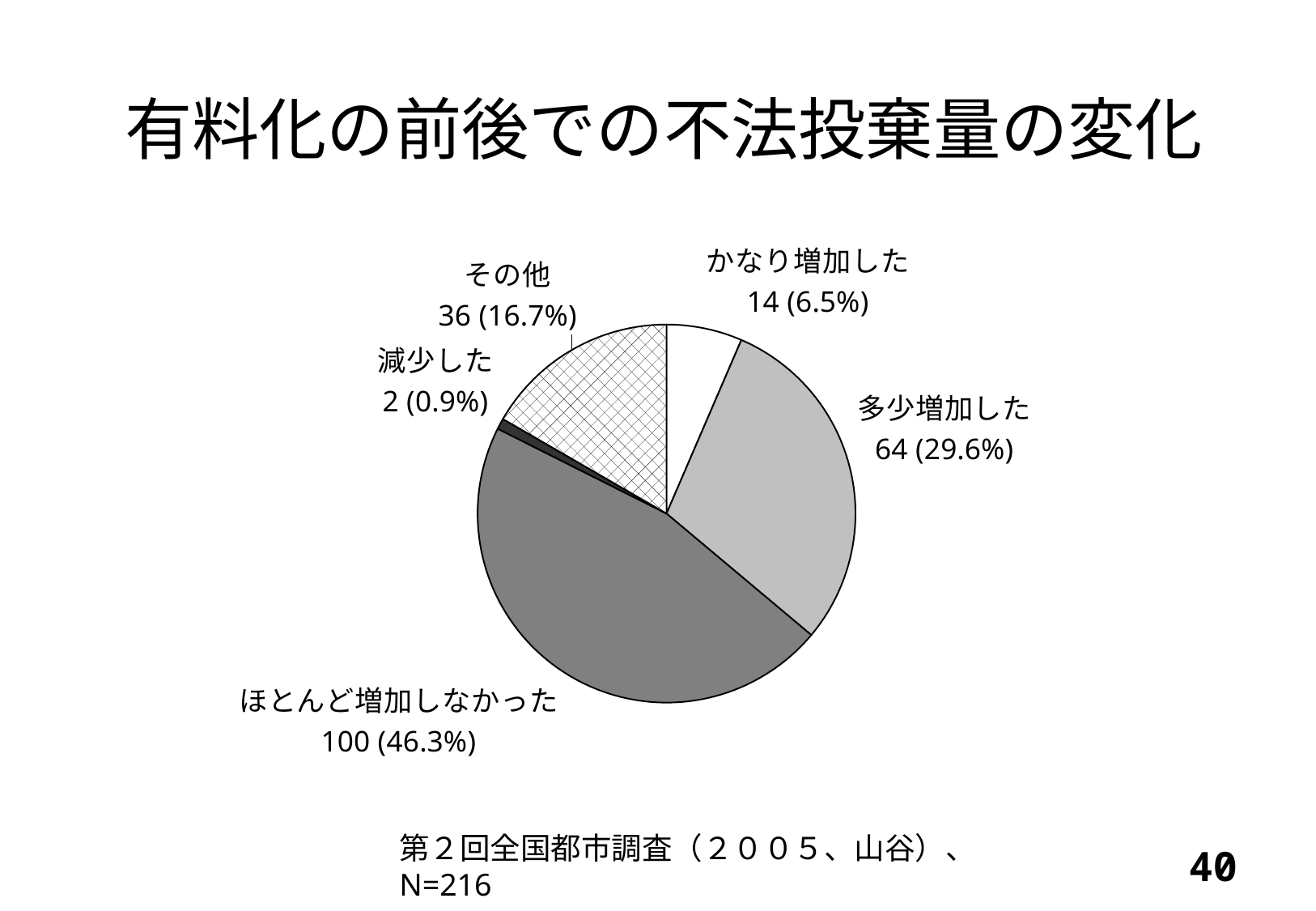
What is the percentage share of 減少した? 0.9% What percentage share does その他 have? 16.7% Which category has the largest slice? ほとんど増加しなかった What is the count for ほとんど増加しなかった? 100 What is the count for かなり増加した? 14 How many slices does the pie chart have? 5 Which is larger, the count for その他 or the count for かなり増加した? その他 What percentage share does 多少増加した have? 29.6% What kind of chart is shown on the slide? pie chart What is the sample size (N) stated on the slide? N=216 Which category has the smallest slice? 減少した What is the difference in count between ほとんど増加しなかった and 多少増加した? 36